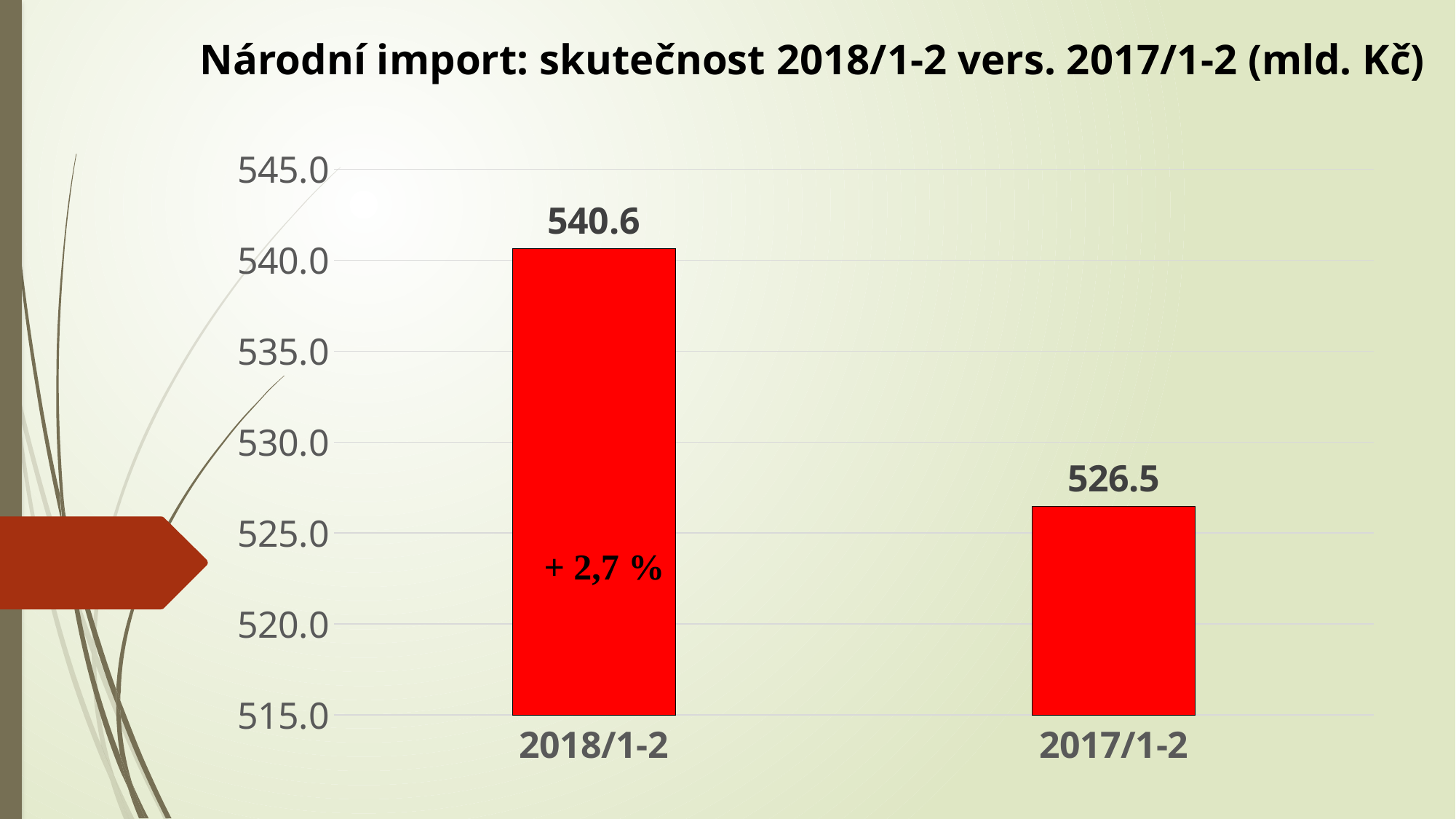
What is the difference between the values for 2018/1-2 and 2017/1-2? 14.1 Is the value for 2018/1-2 greater or less than 535.0? greater What is the value for 2018/1-2? 540.6 What percentage change is printed on the 2018/1-2 bar? + 2,7 % How many categories are shown in the chart? 2 What is the value for 2017/1-2? 526.5 Which category has the lowest value? 2017/1-2 What kind of chart is shown on the slide? bar chart Which category has the highest value? 2018/1-2 What is the title of the chart? Národní import: skutečnost 2018/1-2 vers. 2017/1-2 (mld. Kč) Which is larger, the value for 2018/1-2 or the value for 2017/1-2? 2018/1-2 Is the value for 2017/1-2 greater or less than 530.0? less